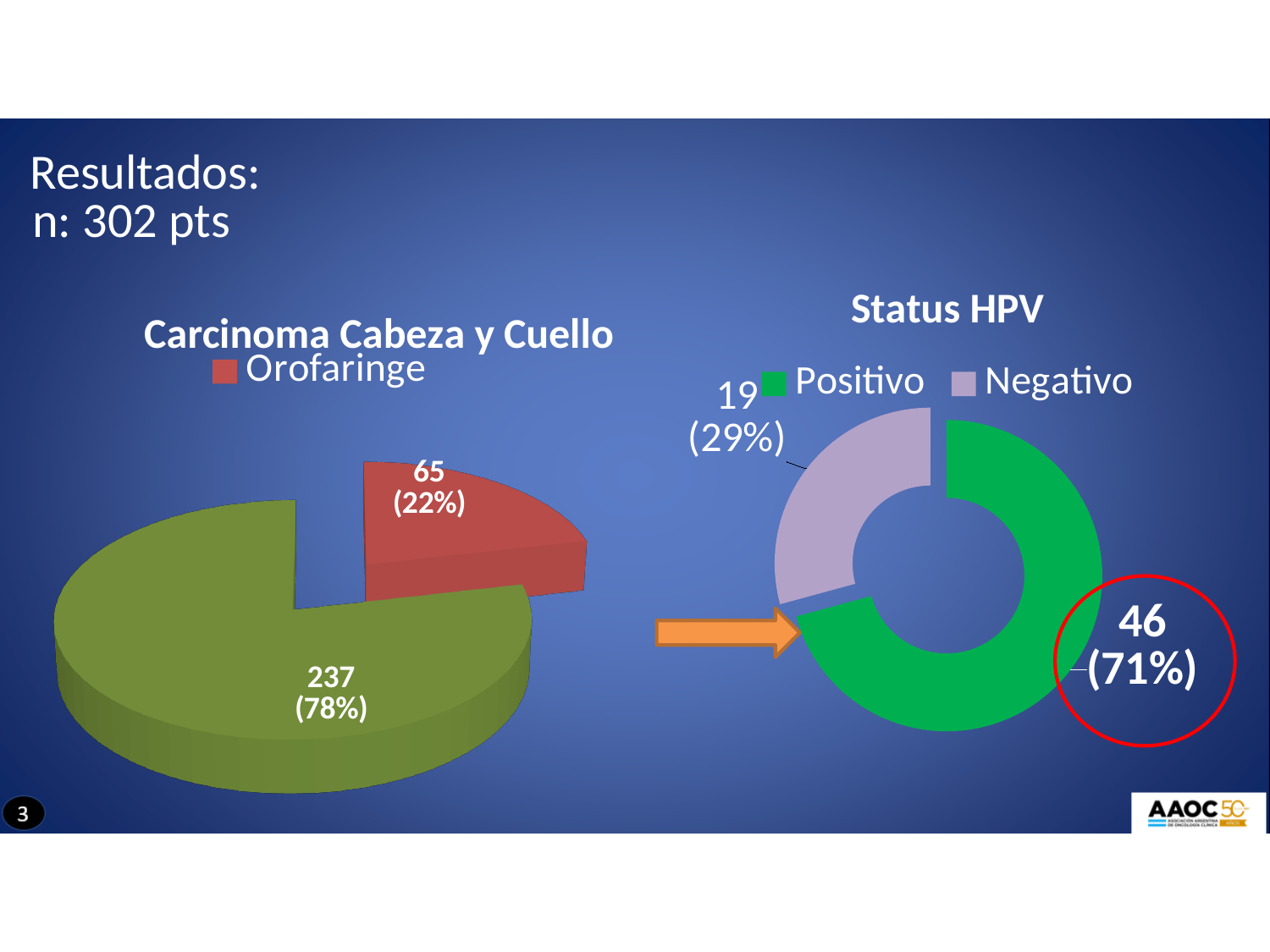
In the 'Carcinoma Cabeza y Cuello' chart, what value is printed on the larger green slice? 237 (78%) In the 'Status HPV' chart, which category is the largest? Positivo How many entries does the legend of the 'Status HPV' chart list? 2 In the 'Status HPV' chart, which category is the smallest? Negativo What kind of chart is 'Carcinoma Cabeza y Cuello'? Pie chart In the 'Carcinoma Cabeza y Cuello' chart, what share of the pie does Orofaringe represent? 22% In the 'Status HPV' chart, what value is shown for Negativo? 19 (29%) In the 'Carcinoma Cabeza y Cuello' chart, what value is shown for Orofaringe? 65 (22%) In the 'Status HPV' chart, what share does Negativo represent? 29% In the 'Status HPV' chart, what is the difference between Positivo and Negativo? 27 In the 'Status HPV' chart, what value is shown for Positivo? 46 (71%) In the 'Carcinoma Cabeza y Cuello' chart, what is the difference between the two slice values, 237 and 65? 172